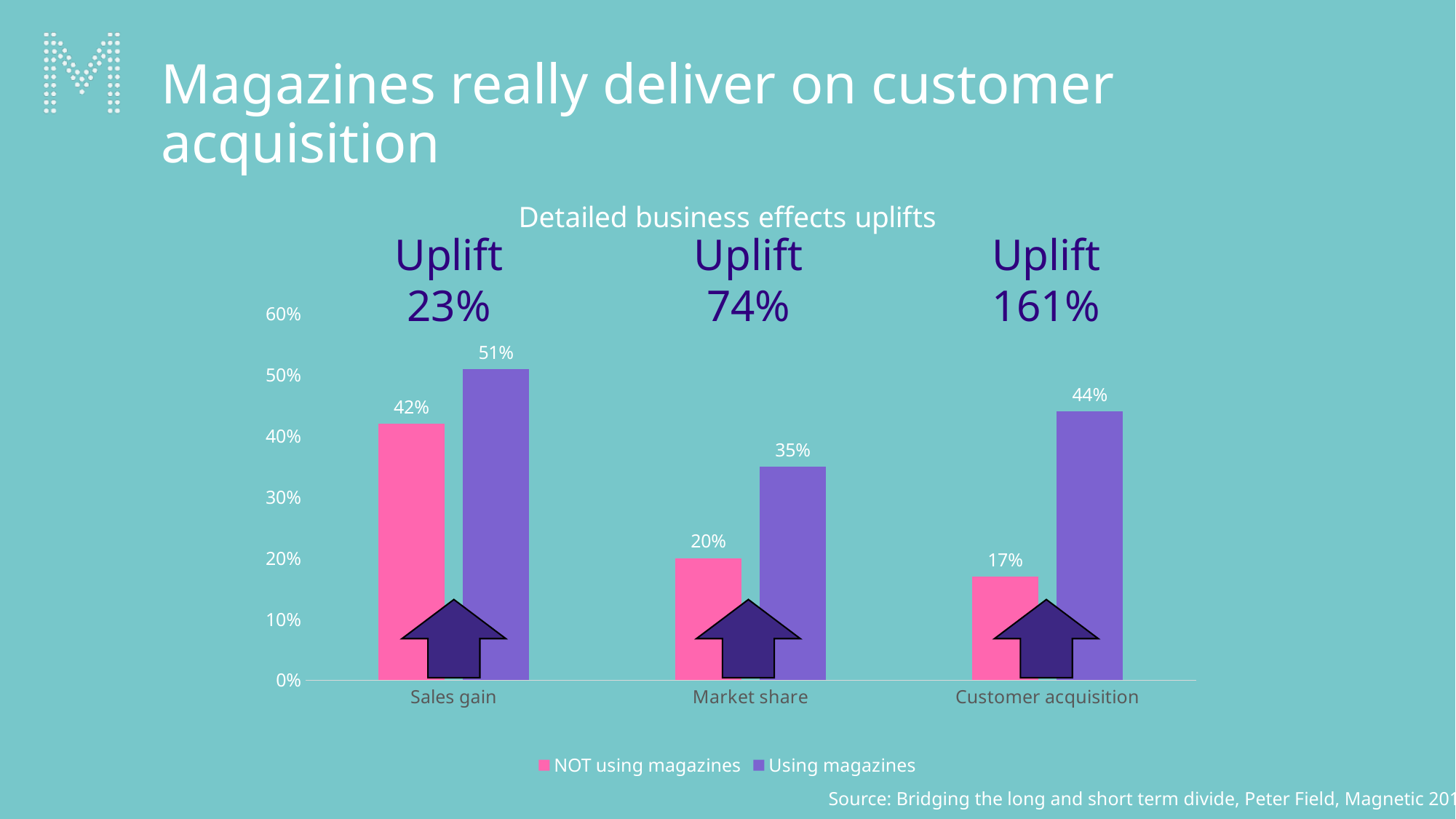
What uplift percentage is shown above the Customer acquisition category? 161% Which category has the highest value for 'NOT using magazines'? Sales gain Which category has the lowest value for 'Using magazines'? Market share What is the value for 'NOT using magazines' in the Market share category? 20% What is the value for 'Using magazines' in the Sales gain category? 51% What is the value for 'Using magazines' in the Customer acquisition category? 44% What is the value for 'NOT using magazines' in the Customer acquisition category? 17% What is the difference between 'Using magazines' and 'NOT using magazines' in the Customer acquisition category? 27% What kind of chart is shown on the slide? Bar chart How many series does the legend list? 2 How many categories are shown on the x axis? 3 Which is larger in the Market share category: 'Using magazines' or 'NOT using magazines'? Using magazines